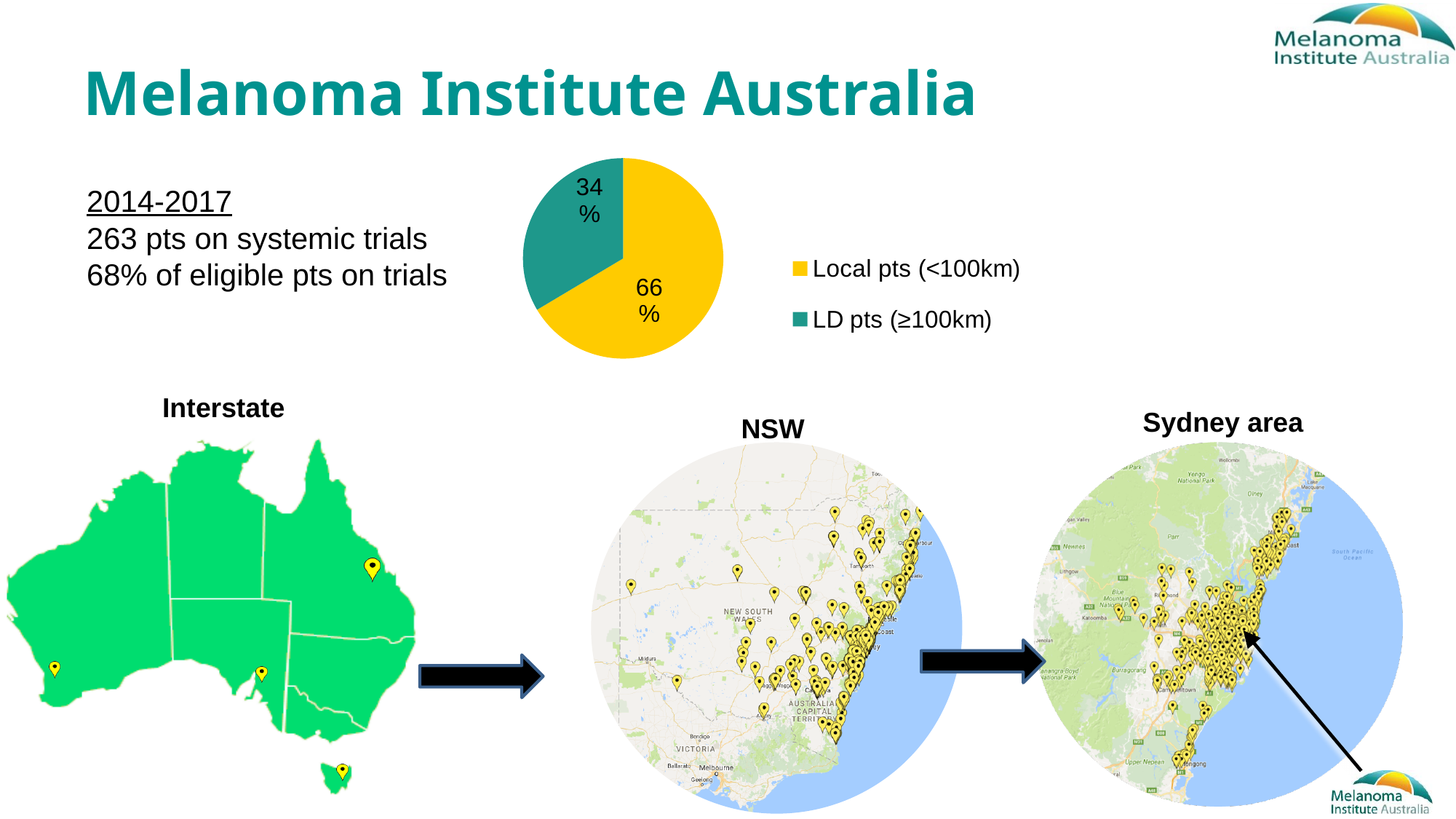
How many entries does the pie chart legend list? 2 How many slices does the pie chart have? 2 Which slice of the pie is the largest? Local pts (<100km) What is the difference in percentage points between the Local pts (<100km) slice and the LD pts (≥100km) slice? 32 What share of the pie is Local pts (<100km)? 66% What colour is the LD pts (≥100km) slice in the pie chart? teal Which slice of the pie is the smallest? LD pts (≥100km) What kind of chart is shown on the slide? pie chart What colour is the Local pts (<100km) slice in the pie chart? yellow Which is larger: the Local pts (<100km) slice or the LD pts (≥100km) slice? Local pts (<100km) What share of the pie is LD pts (≥100km)? 34%